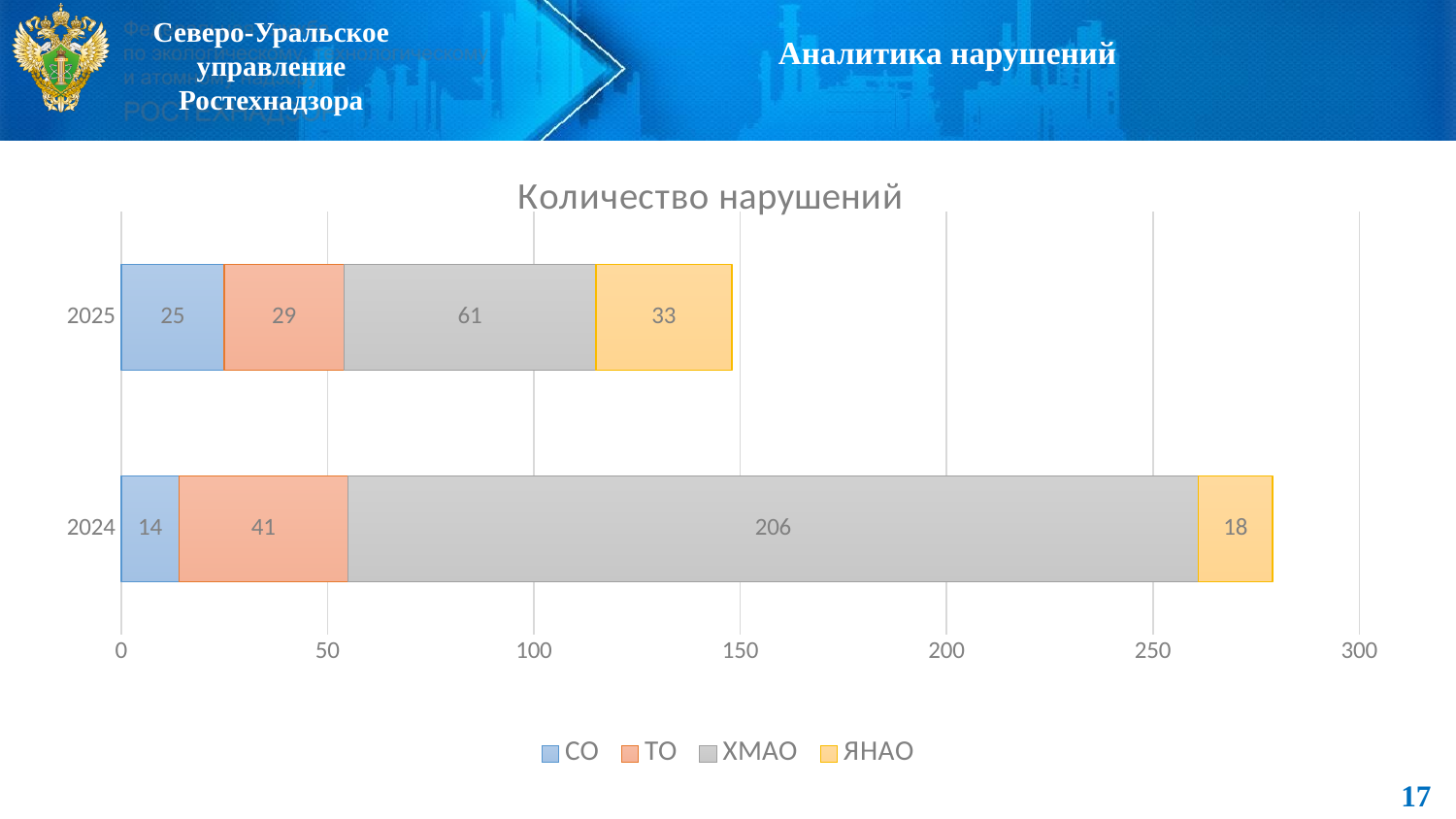
What is the value for ХМАО in 2024? 206 Which series has the lowest value in 2024? СО What is the value for ТО in 2025? 29 Which is larger: the ТО value for 2024 or for 2025? 2024 What is the total of the stacked bar for 2025? 148 How many series does the legend list? 4 What is the difference between the ХМАО values for 2024 and 2025? 145 What type of chart is shown? Stacked bar chart What is the total of the stacked bar for 2024? 279 What is the value for СО in 2024? 14 What is the value for ЯНАО in 2025? 33 Which series has the highest value in 2025? ХМАО